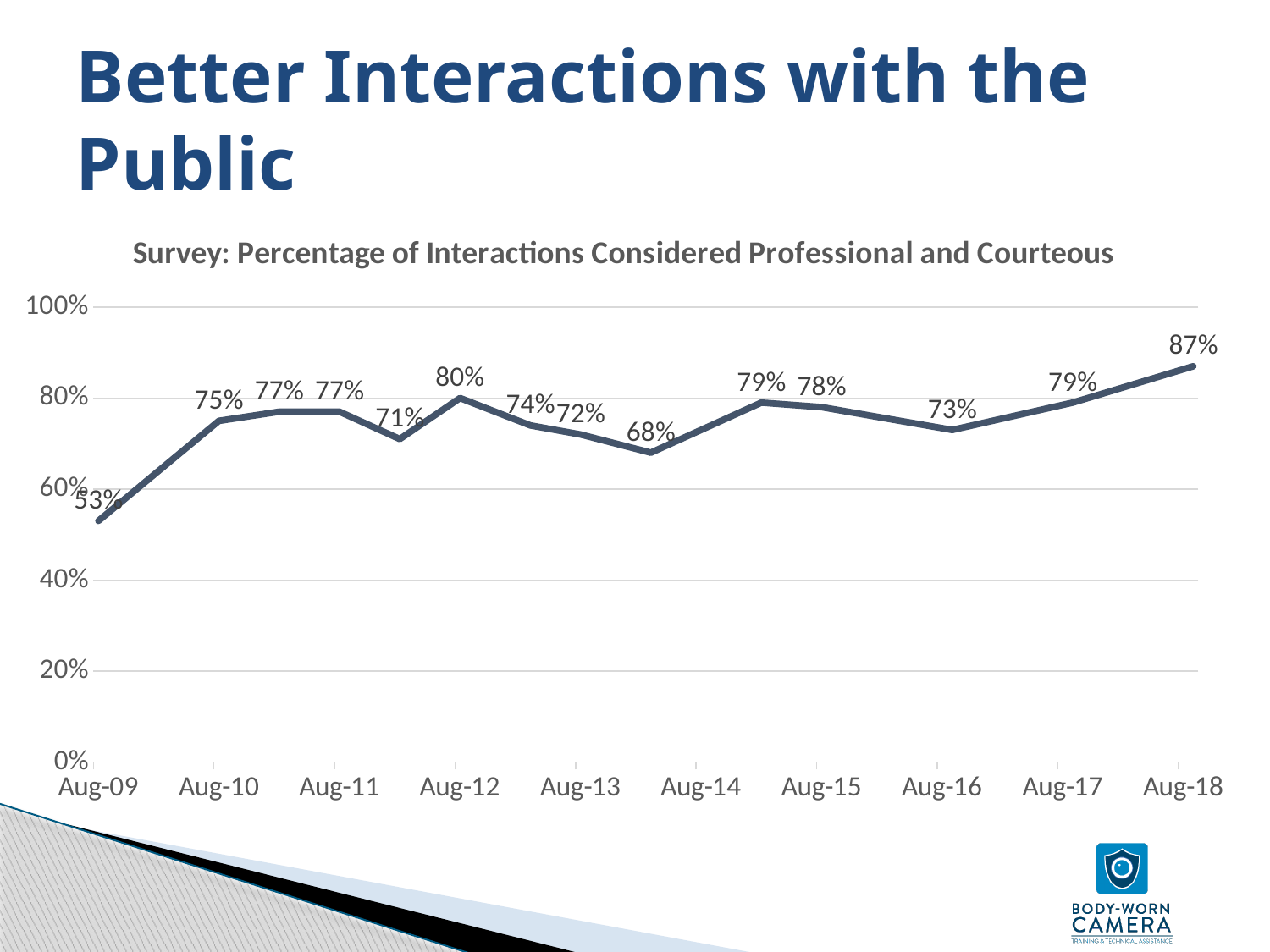
Which point on the line has the highest value? Aug-18 What is the chart's title? Survey: Percentage of Interactions Considered Professional and Courteous Is the value for Aug-13 greater or less than 80%? less How many data points are plotted on the line? 14 What type of chart is shown on the slide? line chart What is the value for Aug-18? 87% What is the value for Aug-12? 80% What is the value for Aug-09? 53% Which is larger, the value for Aug-10 or the value for Aug-17? Aug-17 What is the difference between the values for Aug-18 and Aug-09? 34% Which point on the line has the lowest value? Aug-09 What is the value for Aug-16? 73%